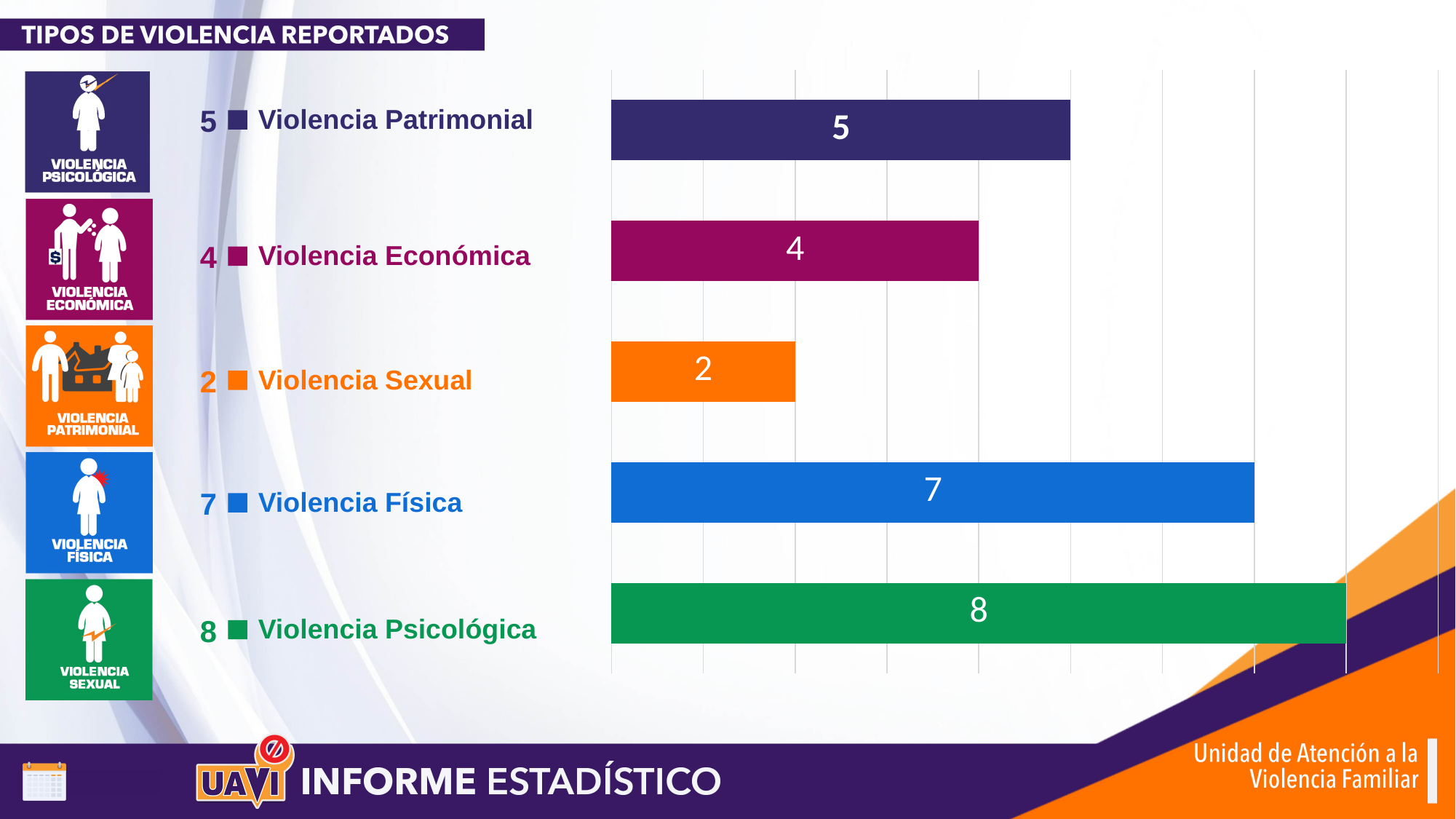
Which type of violence has the lowest value? Violencia Sexual What is the difference between the values for Violencia Física and Violencia Económica? 3 Which is larger, the value for Violencia Patrimonial or the value for Violencia Física? Violencia Física What is the difference between the values for Violencia Psicológica and Violencia Sexual? 6 Which type of violence has the highest value? Violencia Psicológica What is the title of the slide's chart? TIPOS DE VIOLENCIA REPORTADOS How many types of violence are plotted in the chart? 5 What is the value for Violencia Sexual? 2 What is the value for Violencia Patrimonial? 5 What kind of chart is shown on the slide? bar chart What is the value for Violencia Física? 7 What is the value for Violencia Económica? 4